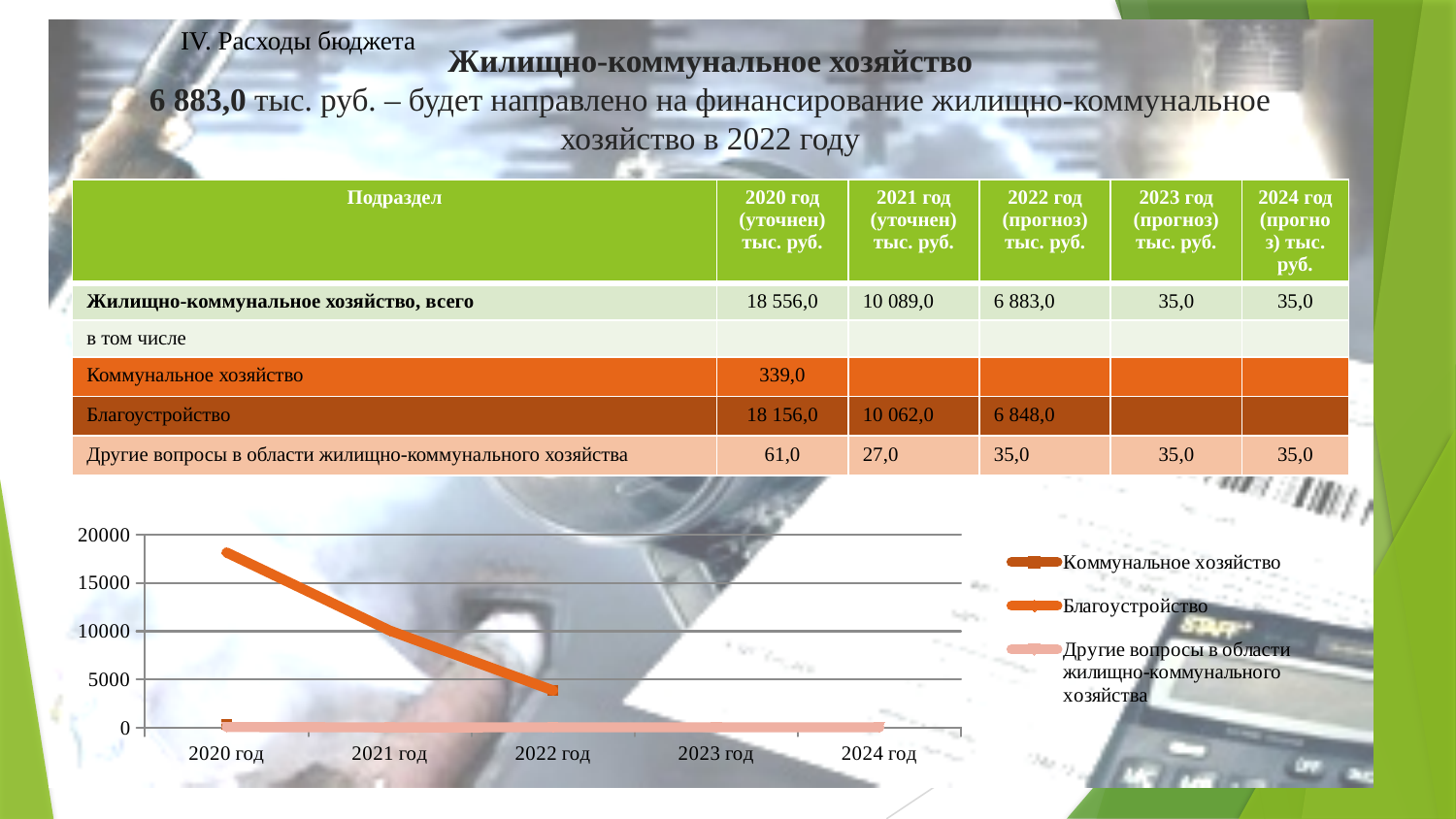
Is the value for Благоустройство in 2021 год greater or less than 5000? greater Is the value for Благоустройство in 2022 год greater or less than 10000? less How many years are shown along the x axis of the chart? 5 What is the first category shown on the x axis of the chart? 2020 год Which series has the highest value in 2021 год? Благоустройство In which year does the Благоустройство line reach its highest value? 2020 год Is the value for Другие вопросы в области жилищно-коммунального хозяйства in 2024 год greater or less than 5000? less Does the Благоустройство line rise or fall from 2020 год to 2022 год? falls What kind of chart is shown on the slide? line chart Which is larger for Благоустройство: the value in 2020 год or in 2022 год? 2020 год How many series does the chart legend list? 3